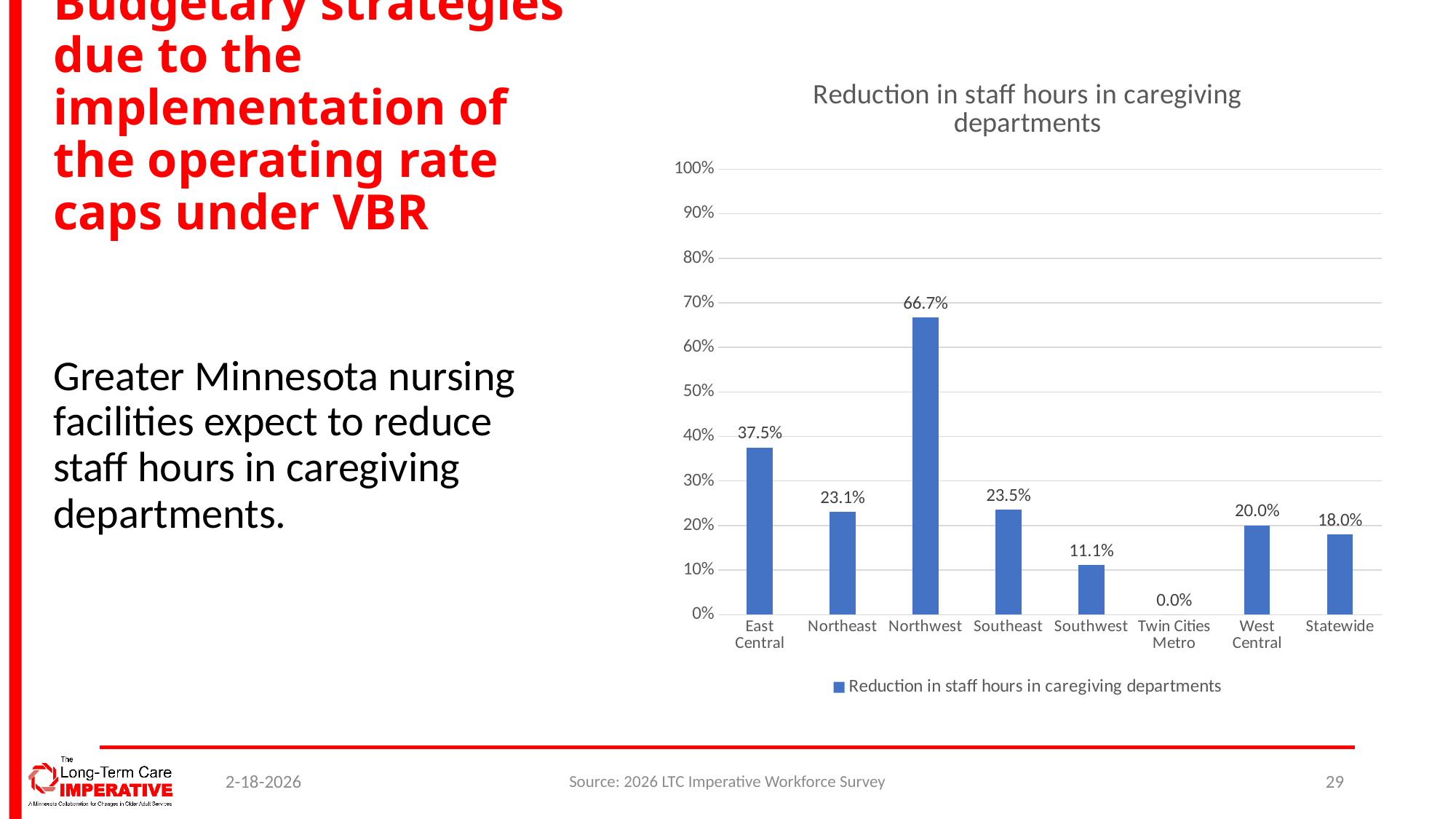
Which region has the lowest value in the chart? Twin Cities Metro What is the title of the chart? Reduction in staff hours in caregiving departments How many categories are shown on the x axis? 8 Which is larger, the value for Southeast or the value for Southwest? Southeast What is the difference between the Northwest and East Central values? 29.2% Is the value for West Central greater or less than 30%? less What is the value for East Central? 37.5% What kind of chart is shown on the slide? bar chart Which region has the highest reduction in staff hours in caregiving departments? Northwest What is the value for Twin Cities Metro? 0.0% What is the Statewide value? 18.0% What is the value for Northwest in the chart? 66.7%